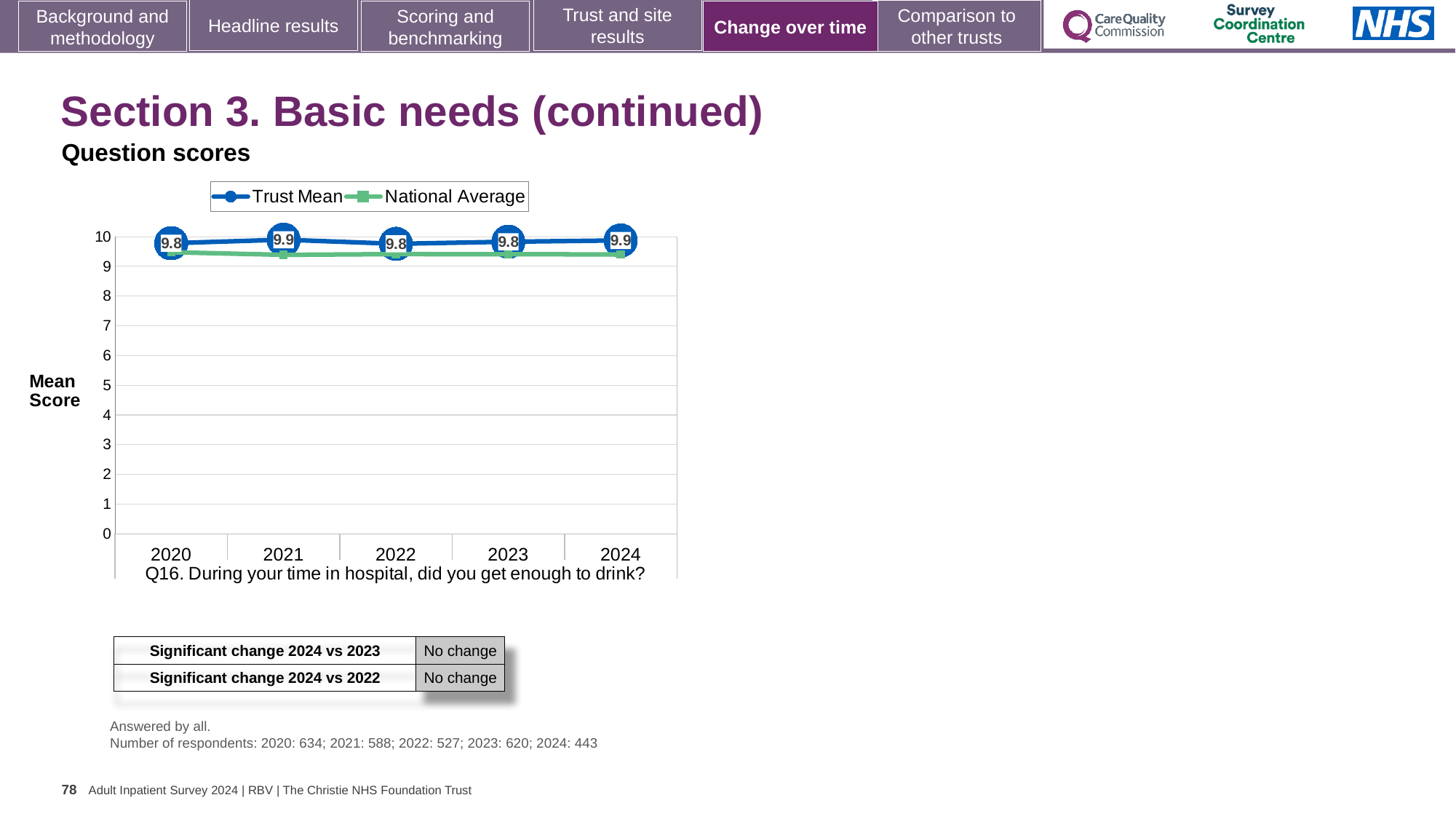
How many series does the legend list? 2 What is the Trust Mean score for 2021? 9.9 Which question does the chart show scores for? Q16. During your time in hospital, did you get enough to drink? In 2024, which is higher: the Trust Mean or the National Average? Trust Mean What is the Trust Mean score for 2020? 9.8 Is the National Average value for 2022 greater or less than 9? greater What is the Trust Mean score for 2023? 9.8 What is the Trust Mean score for 2024? 9.9 How many years are plotted on the x axis? 5 What kind of chart is shown on the slide? Line chart What is the label on the y axis of the chart? Mean Score What is the difference between the Trust Mean scores for 2021 and 2020? 0.1